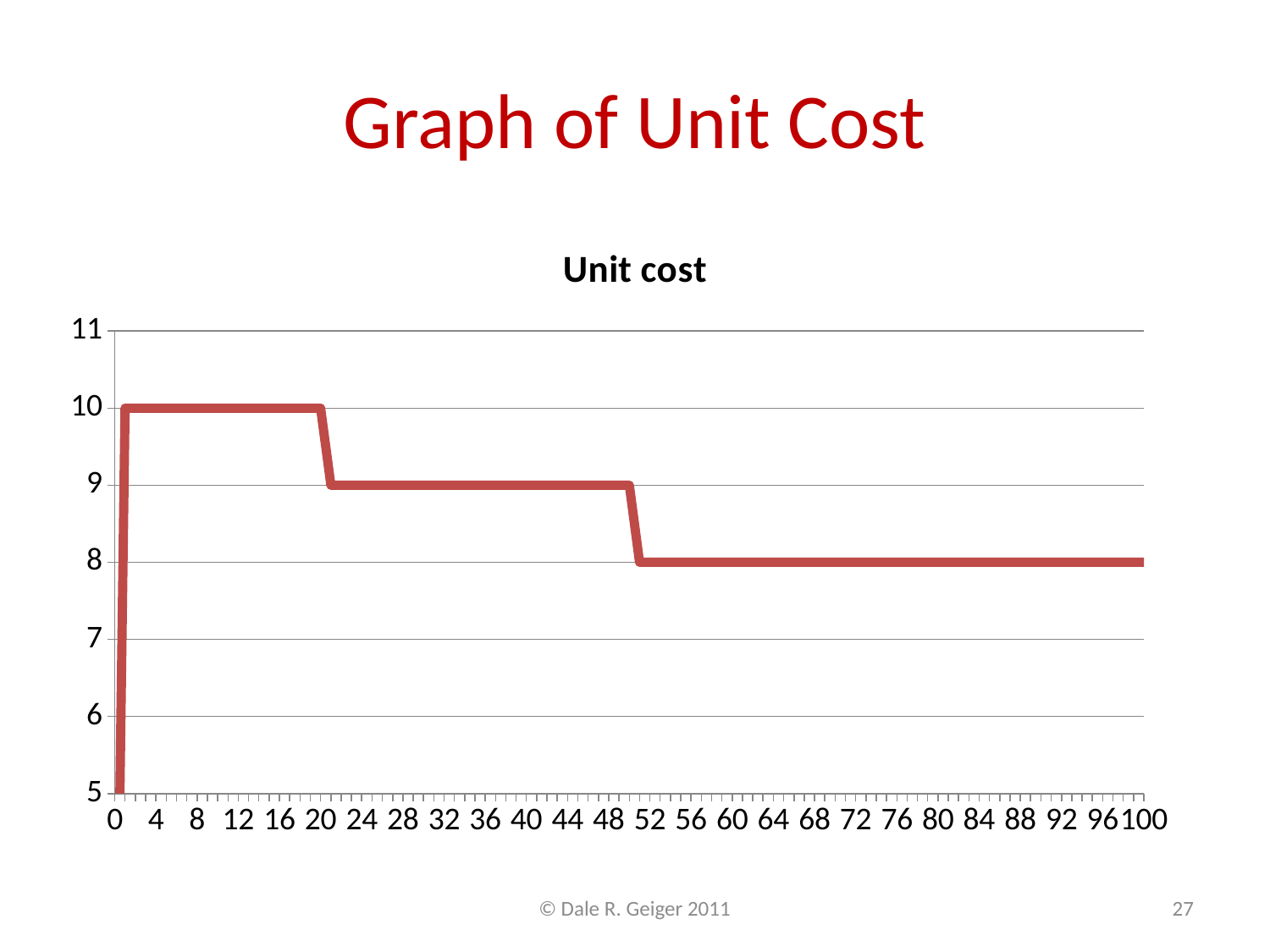
What is the unit cost at x = 80? 8 Is the unit cost at x = 16 greater or less than 9? greater Is the unit cost at x = 60 greater or less than 9? less How many distinct plateau levels does the unit cost line have after its initial rise? 3 What kind of chart is shown on the slide? line chart Does the unit cost rise or fall as x increases from 4 to 100? fall What is the difference between the unit cost at x = 4 and the unit cost at x = 100? 2 Which has the higher unit cost, x = 12 or x = 60? x = 12 What is the unit cost at x = 40? 9 What is the title of the chart? Unit cost What is the unit cost at x = 8? 10 What is the highest value shown on the vertical axis? 11